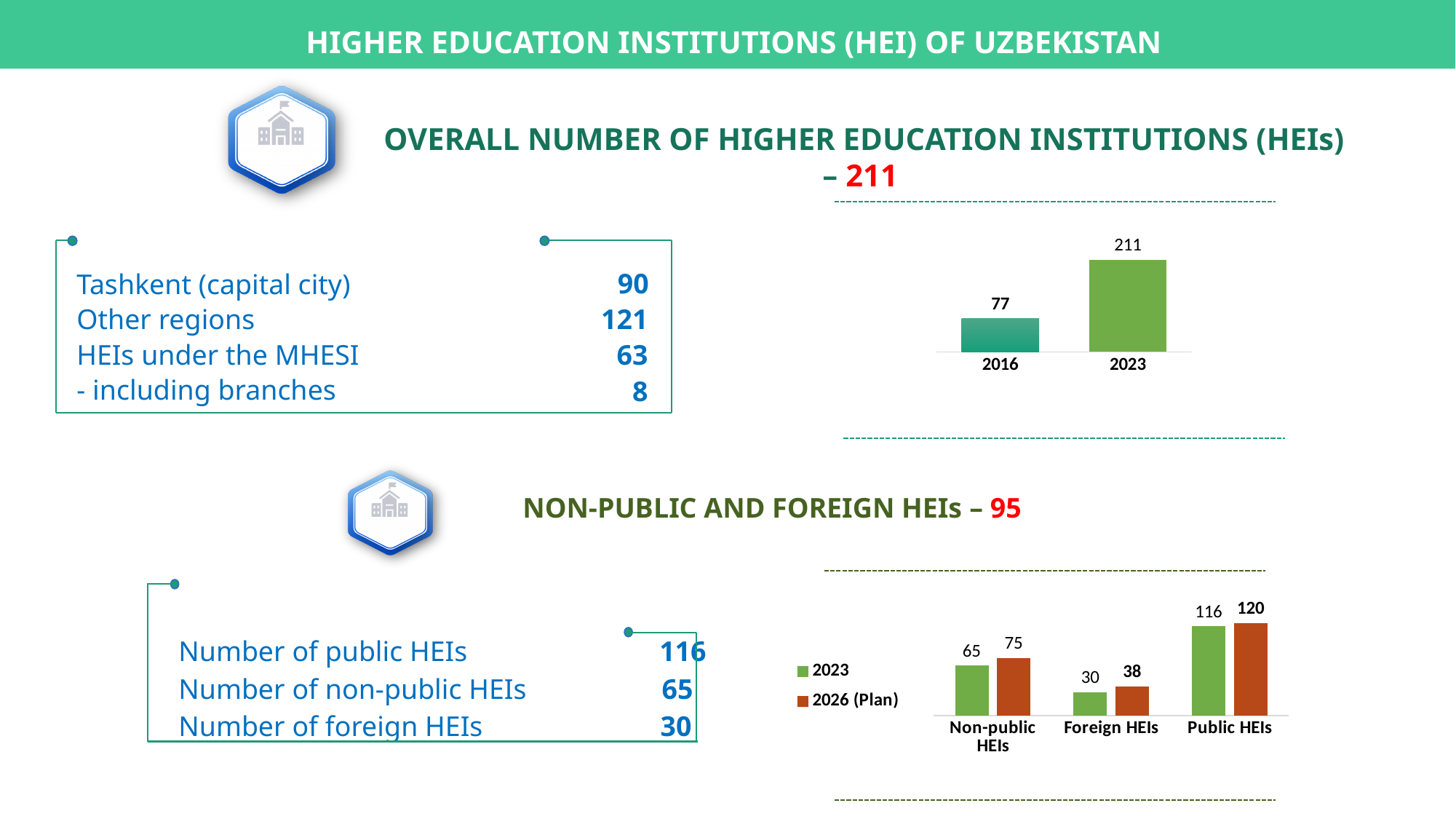
In the bottom chart (Non-public, Foreign, Public HEIs), what is the 2026 (Plan) value for Non-public HEIs? 75 In the bottom chart (Non-public, Foreign, Public HEIs), how many categories are shown on the x axis? 3 In the bottom chart (Non-public, Foreign, Public HEIs), which category has the lowest 2026 (Plan) value? Foreign HEIs In the top chart (2016 vs 2023), what is the value for 2016? 77 In the top chart (2016 vs 2023), what is the value for 2023? 211 In the bottom chart (Non-public, Foreign, Public HEIs), what is the difference between the 2026 (Plan) and 2023 values for Public HEIs? 4 In the bottom chart (Non-public, Foreign, Public HEIs), what is the 2023 value for Foreign HEIs? 30 In the bottom chart (Non-public, Foreign, Public HEIs), which category has the highest 2023 value? Public HEIs In the bottom chart (Non-public, Foreign, Public HEIs), how many series does the legend list? 2 In the top chart (2016 vs 2023), what is the difference between the 2023 and 2016 values? 134 In the top chart (2016 vs 2023), do the values rise or fall from 2016 to 2023? rise In the top chart (2016 vs 2023), what kind of chart is shown? bar chart